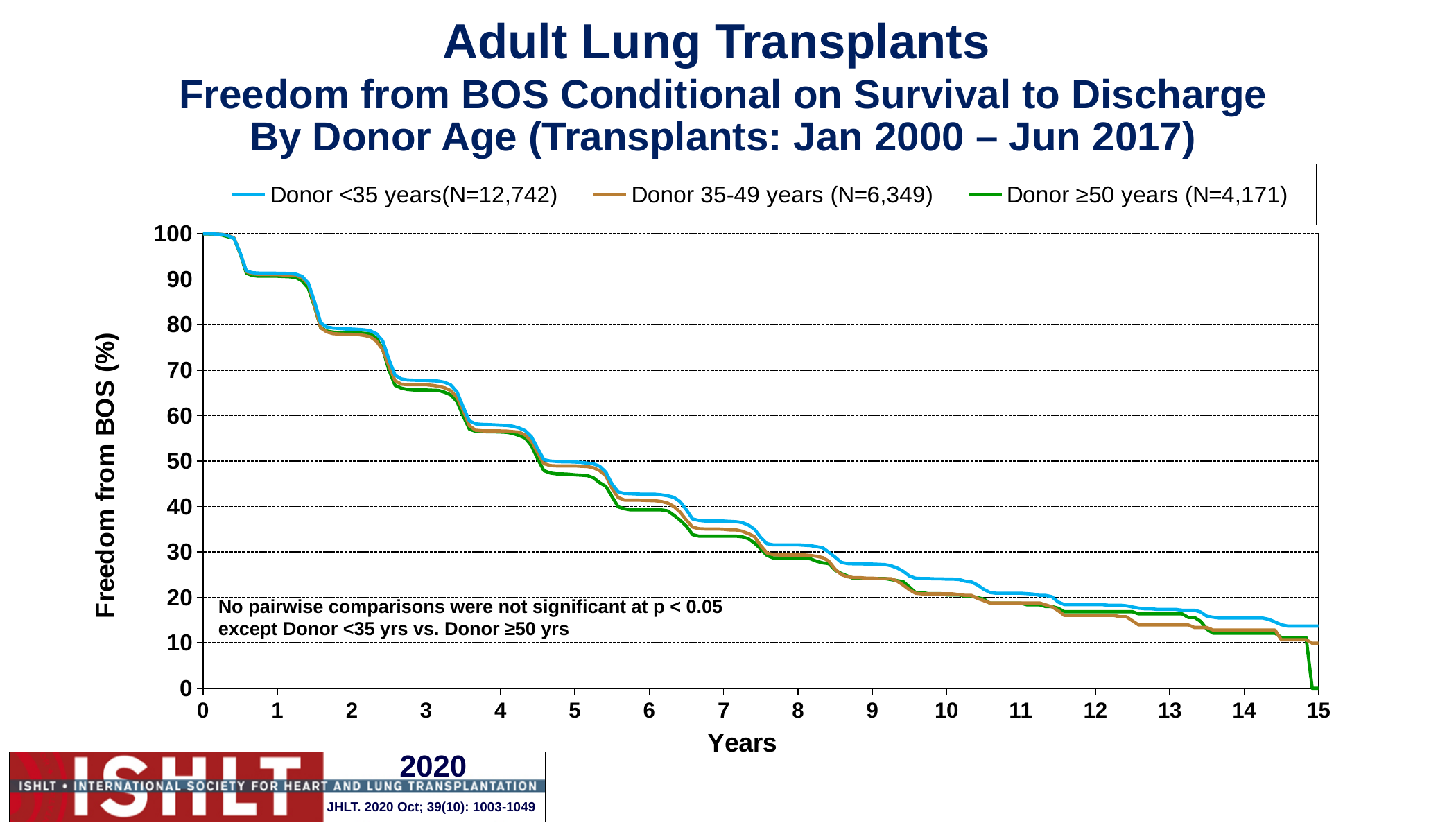
What is the label of the y axis? Freedom from BOS (%) At year 5, which is larger: the value for Donor <35 years or for Donor ≥50 years? Donor <35 years What kind of chart is shown on the slide? line chart Is the value for Donor <35 years at year 3 greater or less than 60? greater Is the value for Donor <35 years at year 10 greater or less than 20? greater Which series has the lowest freedom from BOS at year 6? Donor ≥50 years How many series does the legend list? 3 Is the value for Donor ≥50 years at year 7 greater or less than 30? greater What is the N shown in the legend for Donor <35 years? N=12,742 What is the freedom from BOS value for Donor ≥50 years at year 0? 100 Do the values for Donor <35 years rise or fall as years increase? fall